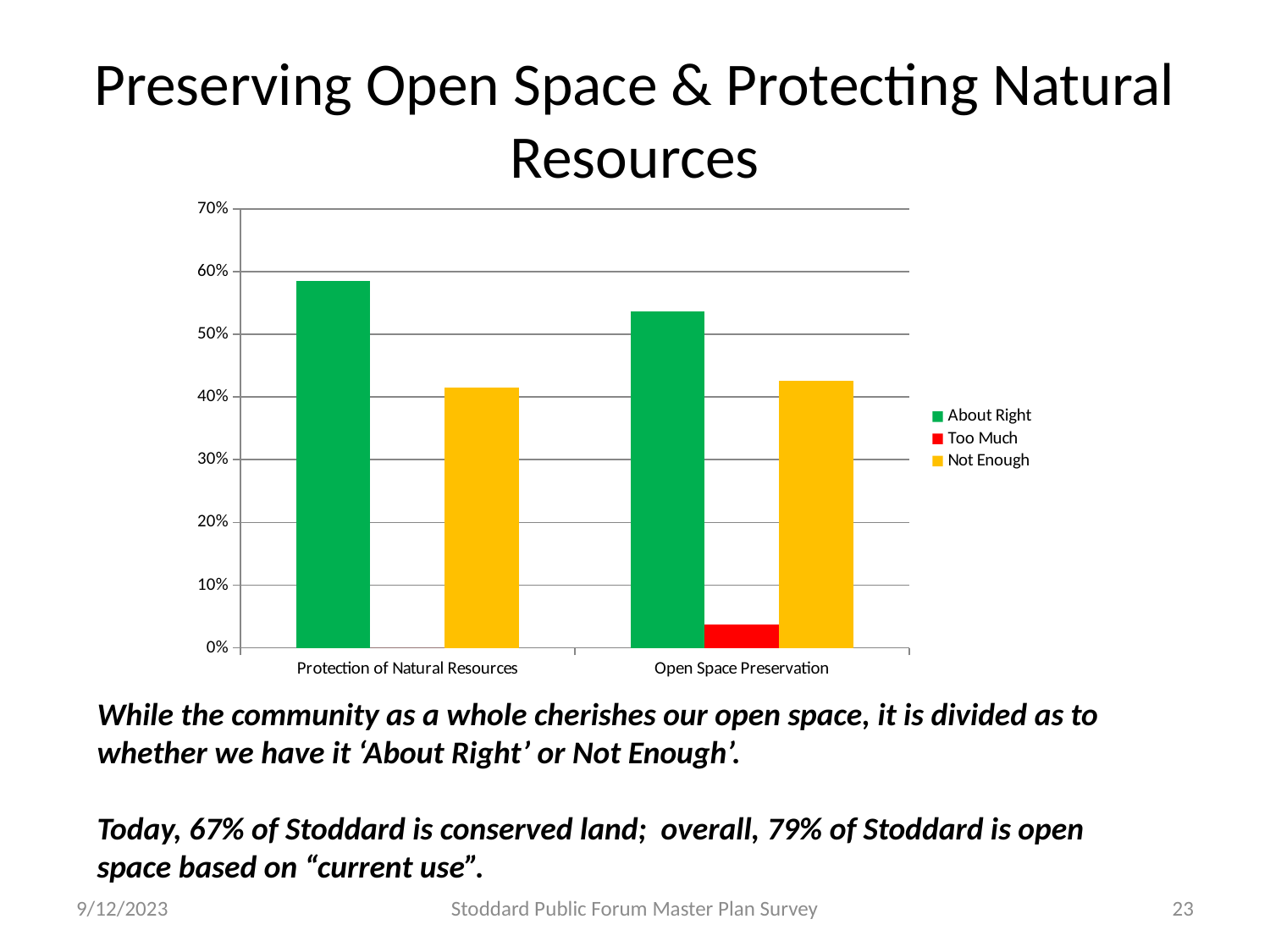
For Protection of Natural Resources, which is larger: 'About Right' or 'Not Enough'? About Right How many categories are shown on the x axis of the chart? 2 For Open Space Preservation, which series has the highest value? About Right What colour represents the 'Too Much' series in the chart? red How many series does the chart's legend list? 3 For Open Space Preservation, which series has the lowest value? Too Much Is the 'About Right' value for Protection of Natural Resources greater or less than 50%? greater Is the 'About Right' value for Open Space Preservation greater or less than 50%? greater Is the 'Too Much' value for Open Space Preservation greater or less than 10%? less What kind of chart is shown on the slide? bar chart Which category has the larger 'About Right' value: Protection of Natural Resources or Open Space Preservation? Protection of Natural Resources